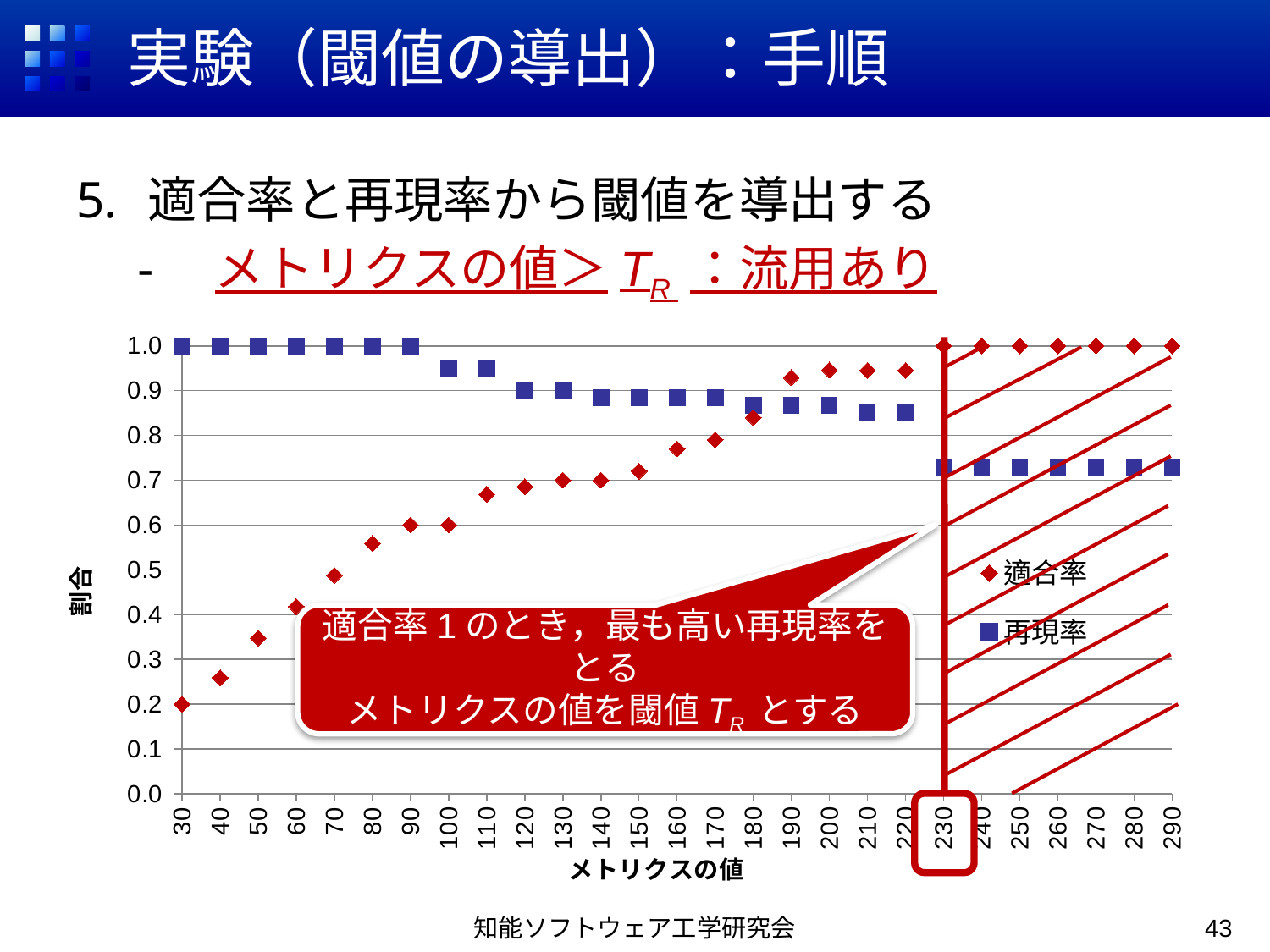
Does 適合率 rise or fall as the metric value increases along the x axis? rise Is the value of 適合率 at metric value 60 greater or less than 0.5? less What is the title of the x axis? メトリクスの値 How many series does the legend list? 2 Is the value of 適合率 at metric value 200 greater or less than 0.9? greater What is the value of 再現率 at metric value 30? 1.0 Is the value of 再現率 at metric value 250 greater or less than 0.8? less At metric value 100, which series has the larger value, 適合率 or 再現率? 再現率 What is the value of 適合率 at metric value 290? 1.0 What kind of chart is shown on the slide? scatter chart How many x-axis values (metric values) are plotted? 27 What are the two series named in the legend? 適合率 and 再現率